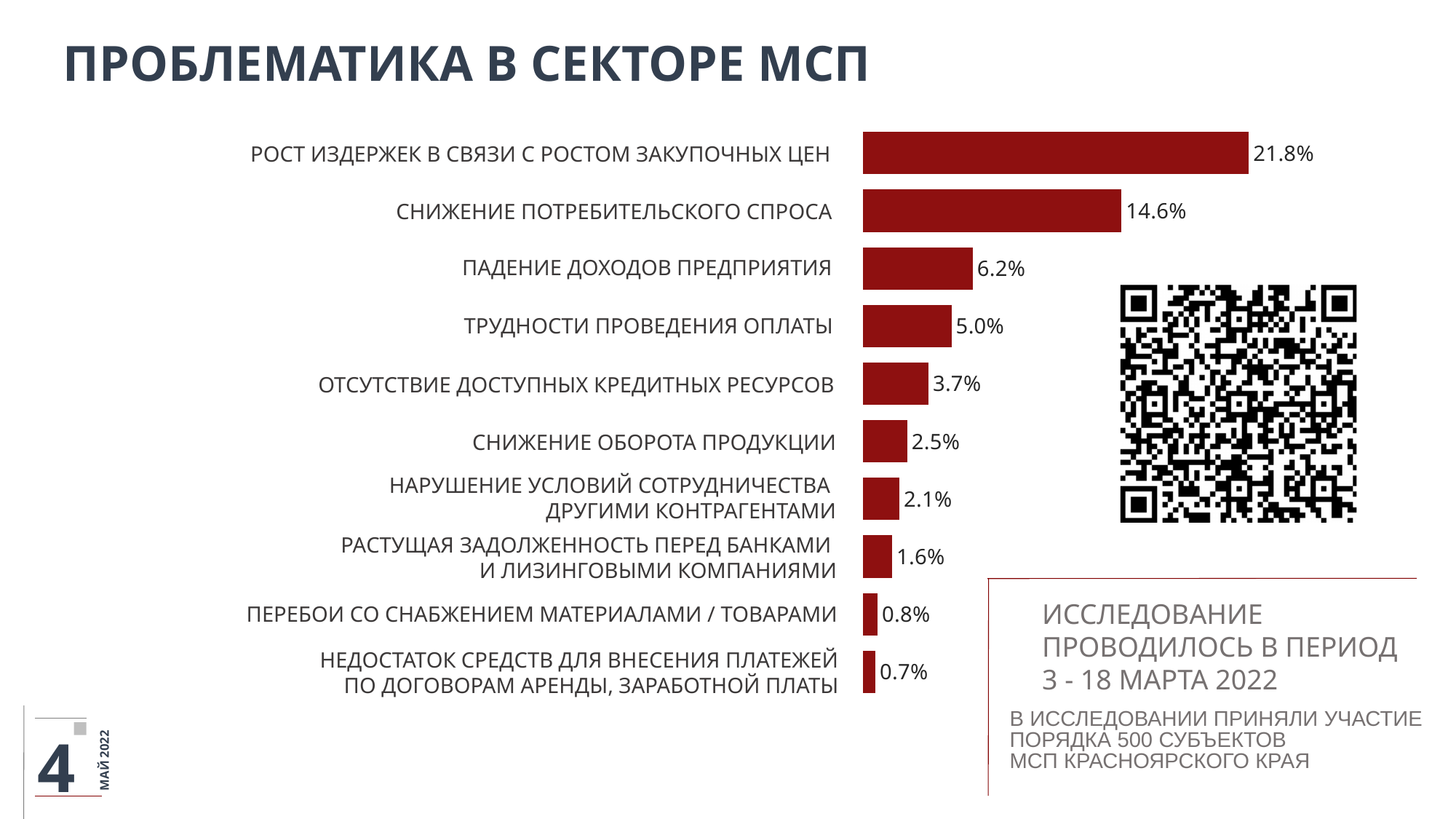
How many categories are shown in the chart? 10 What is the value for ОТСУТСТВИЕ ДОСТУПНЫХ КРЕДИТНЫХ РЕСУРСОВ? 3.7% What is the value for ПЕРЕБОИ СО СНАБЖЕНИЕМ МАТЕРИАЛАМИ / ТОВАРАМИ? 0.8% What is the value for РОСТ ИЗДЕРЖЕК В СВЯЗИ С РОСТОМ ЗАКУПОЧНЫХ ЦЕН? 21.8% What is the difference between the values for РОСТ ИЗДЕРЖЕК В СВЯЗИ С РОСТОМ ЗАКУПОЧНЫХ ЦЕН and СНИЖЕНИЕ ПОТРЕБИТЕЛЬСКОГО СПРОСА? 7.2% What kind of chart is shown on the slide? Bar chart What is the difference between the values for ПАДЕНИЕ ДОХОДОВ ПРЕДПРИЯТИЯ and ТРУДНОСТИ ПРОВЕДЕНИЯ ОПЛАТЫ? 1.2% What is the title of the slide containing the chart? ПРОБЛЕМАТИКА В СЕКТОРЕ МСП Which is larger: the value for СНИЖЕНИЕ ОБОРОТА ПРОДУКЦИИ or the value for НАРУШЕНИЕ УСЛОВИЙ СОТРУДНИЧЕСТВА ДРУГИМИ КОНТРАГЕНТАМИ? СНИЖЕНИЕ ОБОРОТА ПРОДУКЦИИ What is the value for СНИЖЕНИЕ ПОТРЕБИТЕЛЬСКОГО СПРОСА? 14.6% Which category has the highest value? РОСТ ИЗДЕРЖЕК В СВЯЗИ С РОСТОМ ЗАКУПОЧНЫХ ЦЕН Which category has the lowest value? НЕДОСТАТОК СРЕДСТВ ДЛЯ ВНЕСЕНИЯ ПЛАТЕЖЕЙ ПО ДОГОВОРАМ АРЕНДЫ, ЗАРАБОТНОЙ ПЛАТЫ